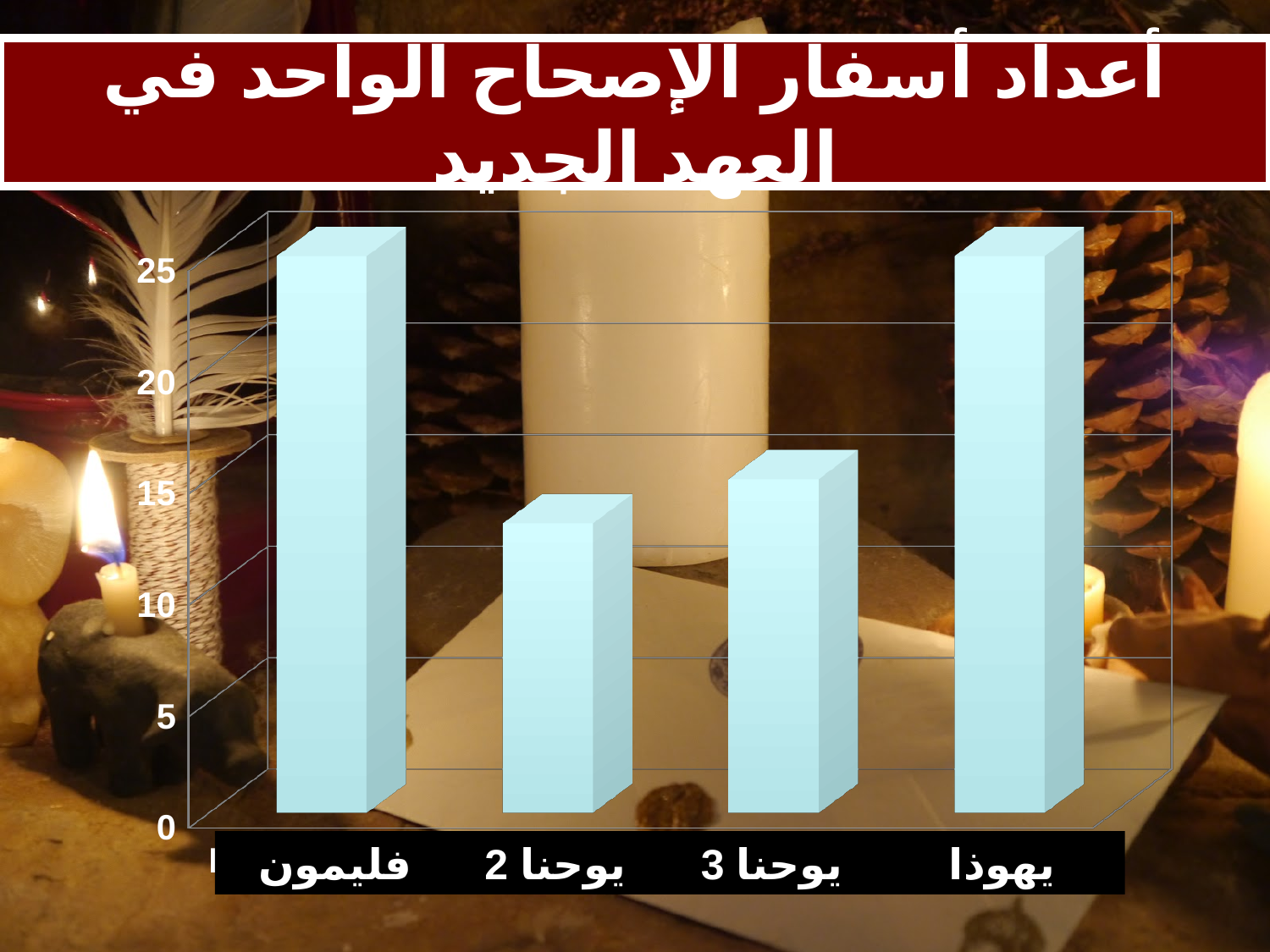
Is the value for يهوذا greater or less than 20? greater Is the value for يوحنا 3 greater or less than 20? less How many categories (books) are shown on the x axis of the chart? 4 Is the value for يوحنا 2 greater or less than 10? greater What is the title of the chart on the slide? أعداد أسفار الإصحاح الواحد في العهد الجديد Which is larger, the value for يوحنا 2 or the value for يوحنا 3? يوحنا 3 Which category has the lowest bar in the chart? يوحنا 2 What colour are the bars in the chart? light blue What kind of chart is shown on the slide? bar chart